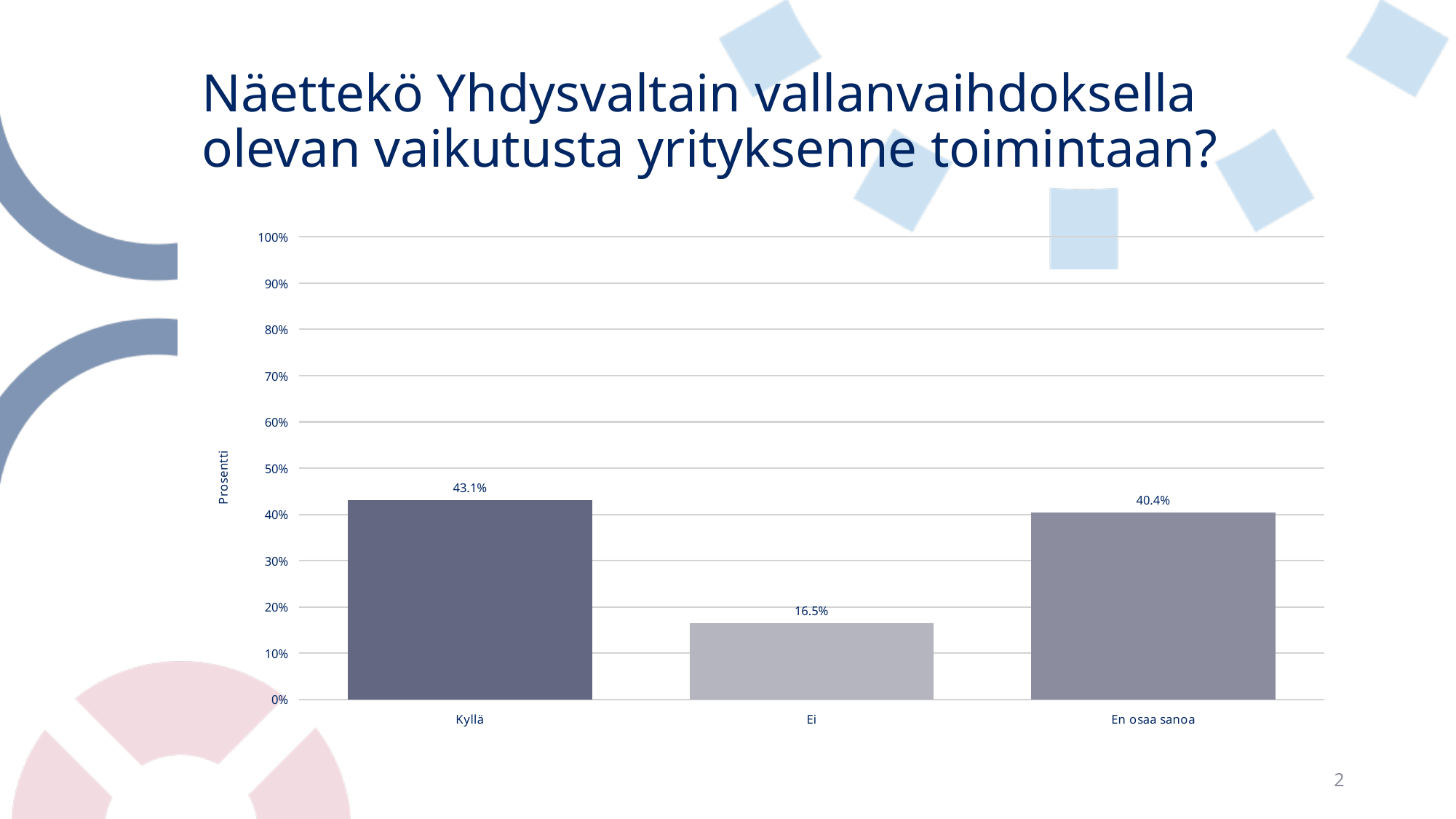
What kind of chart is shown on the slide? bar chart What is the label of the y axis? Prosentti Which is larger, the value for Ei or the value for En osaa sanoa? En osaa sanoa What is the difference between the values for Kyllä and Ei? 26.6% What is the value for Kyllä? 43.1% Is the value for Ei greater or less than 20%? less What is the value for Ei? 16.5% Which category has the lowest value? Ei What is the value for En osaa sanoa? 40.4% What is the difference between the values for Kyllä and En osaa sanoa? 2.7% Which category has the highest value? Kyllä How many categories are shown on the x axis? 3